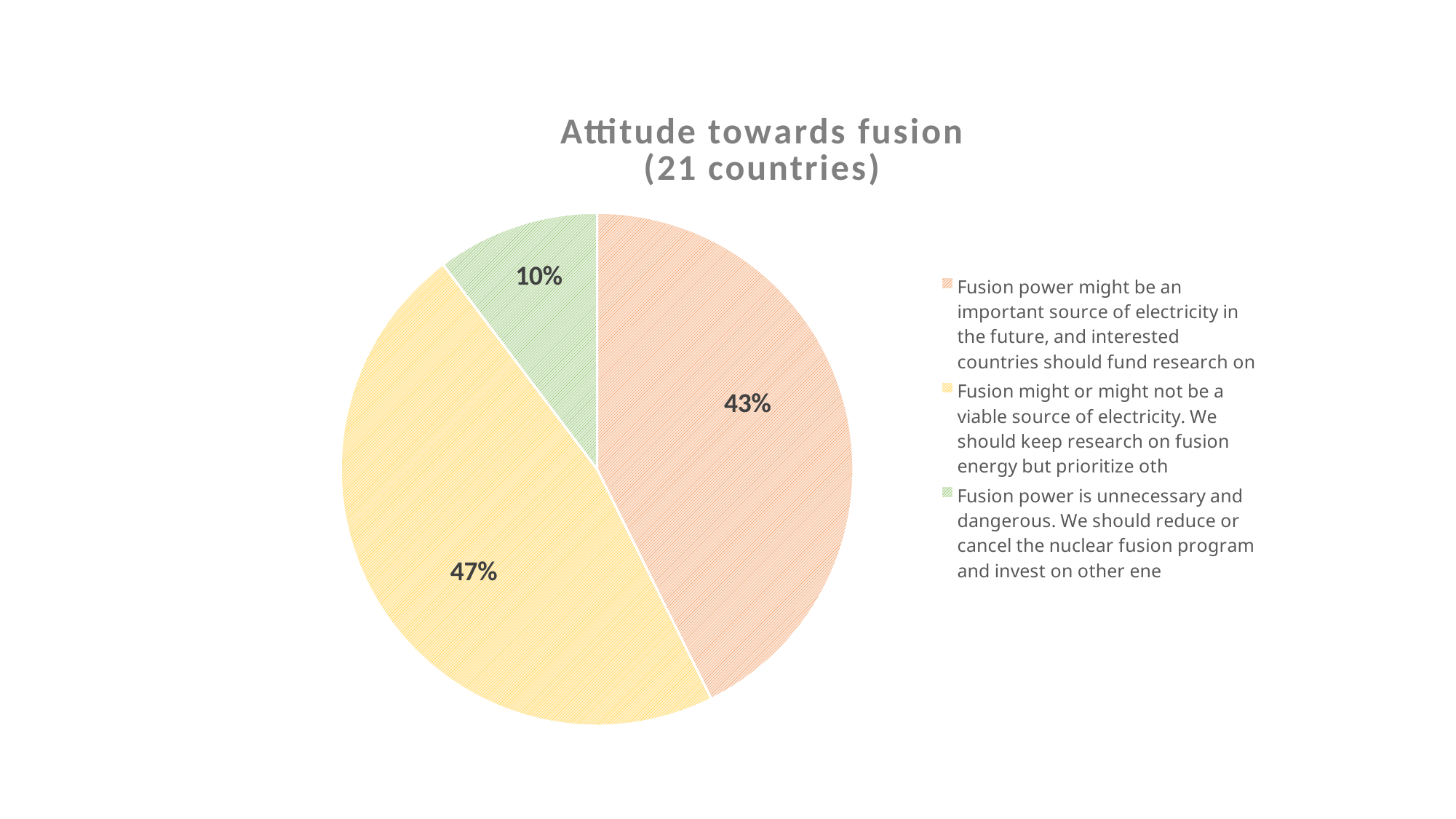
What share of the pie is labelled for the slice "Fusion might or might not be a viable source of electricity. We should keep research on fusion energy but prioritize oth"? 47% What kind of chart is shown on the slide? Pie chart What is the difference in percentage points between the 47% slice and the 43% slice? 4 percentage points Which is larger: the slice for "Fusion power might be an important source of electricity..." or the slice for "Fusion power is unnecessary and dangerous..."? Fusion power might be an important source of electricity... How many slices does the pie chart have? 3 What share of the pie is labelled for the slice "Fusion power might be an important source of electricity in the future, and interested countries should fund research on"? 43% Which slice of the pie is the smallest? Fusion power is unnecessary and dangerous. We should reduce or cancel the nuclear fusion program and invest on other ene What is the title of the chart? Attitude towards fusion (21 countries) What is the difference in percentage points between the largest slice and the smallest slice? 37 percentage points What share of the pie is labelled for the slice "Fusion power is unnecessary and dangerous. We should reduce or cancel the nuclear fusion program and invest on other ene"? 10% Which slice of the pie is the largest? Fusion might or might not be a viable source of electricity. We should keep research on fusion energy but prioritize oth What colour is the slice representing "Fusion power is unnecessary and dangerous..."? Green